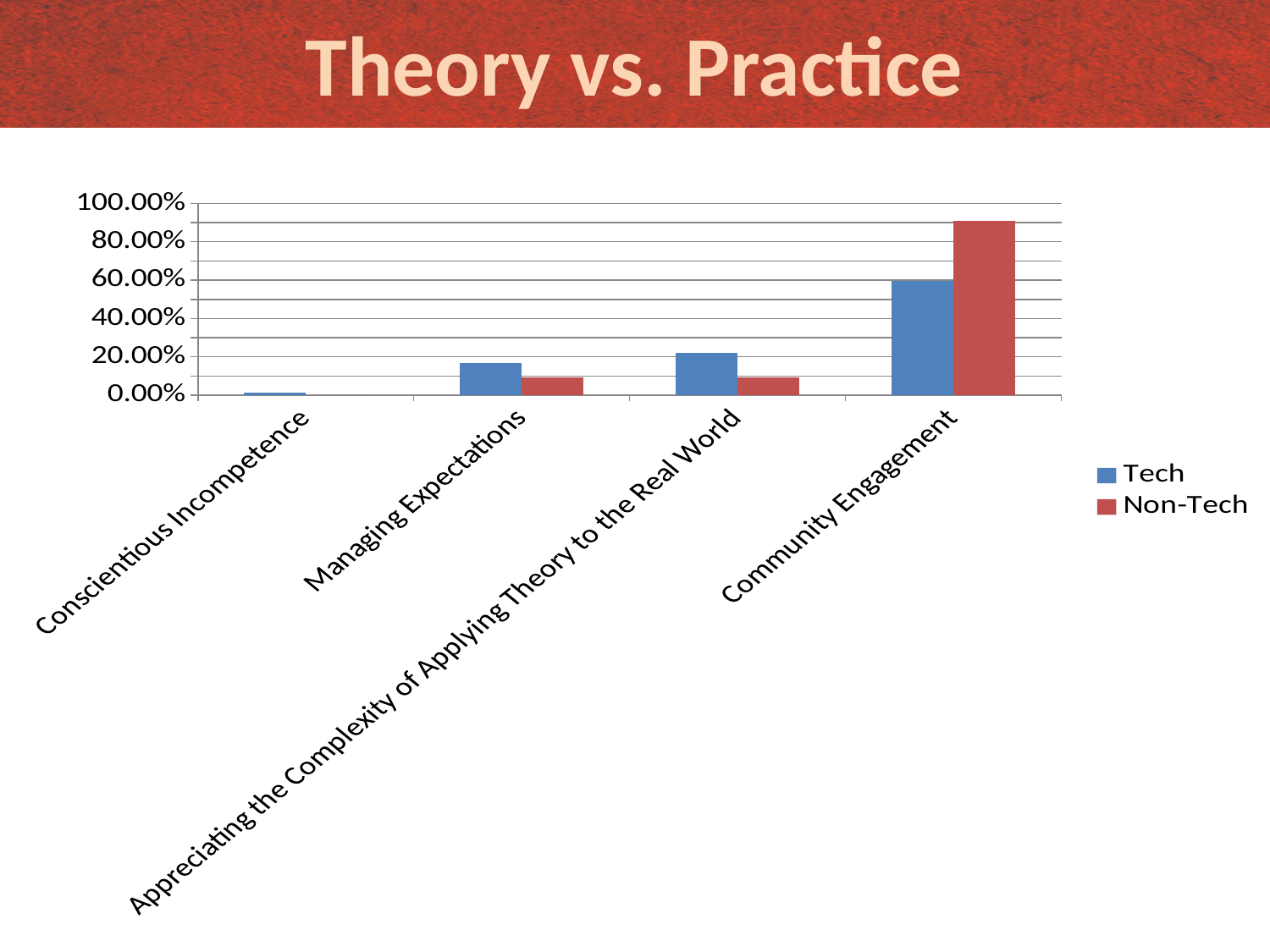
Which category has the lowest Tech value? Conscientious Incompetence What is the title of the slide containing the chart? Theory vs. Practice Is the Tech value for Community Engagement greater or less than 80.00%? less For Community Engagement, which series has the larger value, Tech or Non-Tech? Non-Tech Is the Non-Tech value for Community Engagement greater or less than 80.00%? greater What kind of chart is shown on the slide? bar chart How many categories are shown on the x axis? 4 How many series does the legend list? 2 For Managing Expectations, which series has the larger value, Tech or Non-Tech? Tech Which category has the highest Non-Tech value? Community Engagement Which category has the highest Tech value? Community Engagement Is the Tech value for Managing Expectations greater or less than 20.00%? less